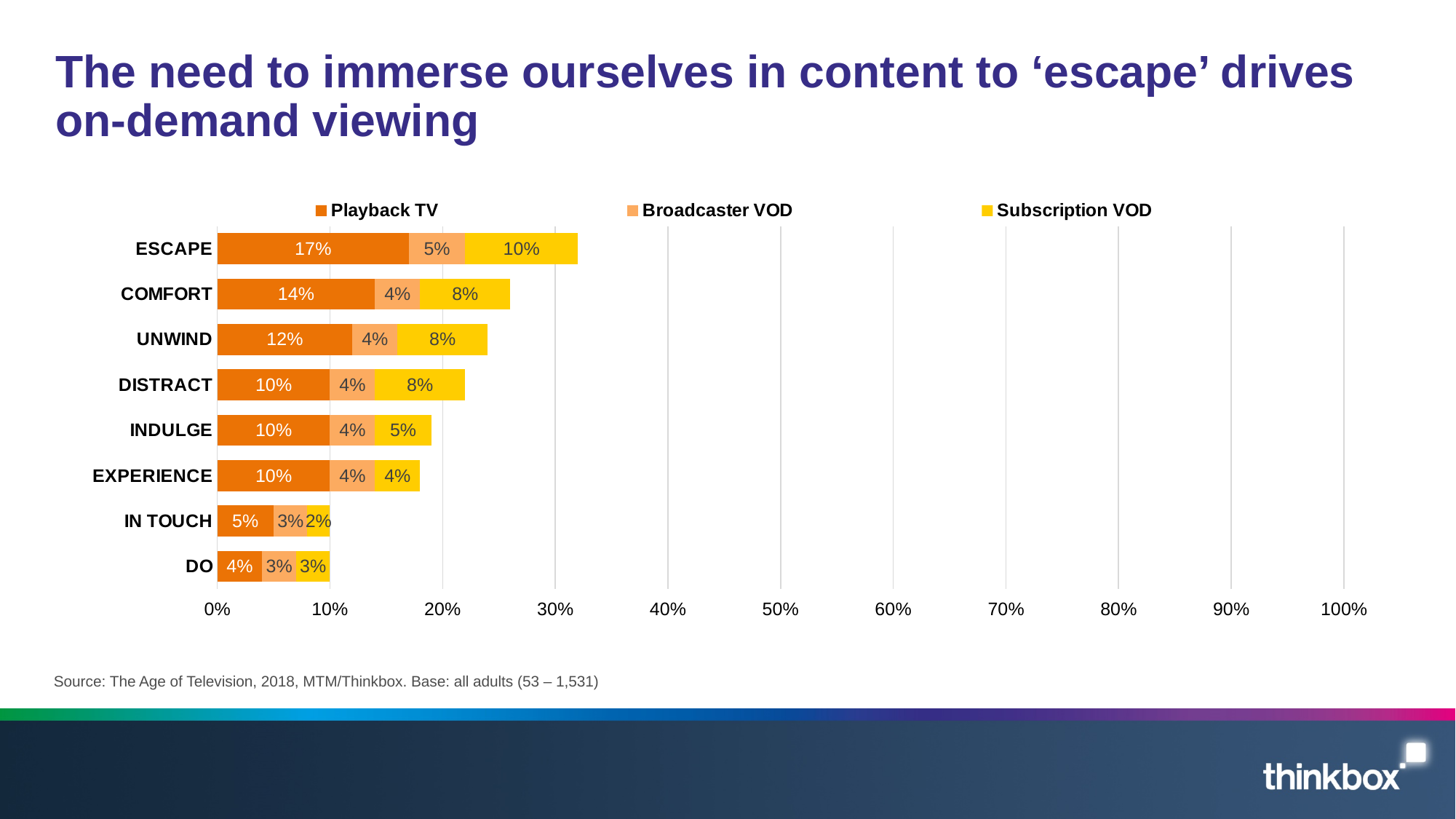
How many categories are shown on the chart? 8 What is the total of the stacked bar for ESCAPE? 32% What is the total of the stacked bar for DO? 10% How many series does the legend list? 3 What is the difference between the Playback TV values for ESCAPE and COMFORT? 3% What is the Subscription VOD value for COMFORT? 8% Which category has the lowest Subscription VOD value? IN TOUCH What is the Broadcaster VOD value for IN TOUCH? 3% Which is larger: the Subscription VOD value for INDULGE or for EXPERIENCE? INDULGE What is the Playback TV value for ESCAPE? 17% What kind of chart is shown on the slide? Stacked bar chart Which category has the highest Playback TV value? ESCAPE